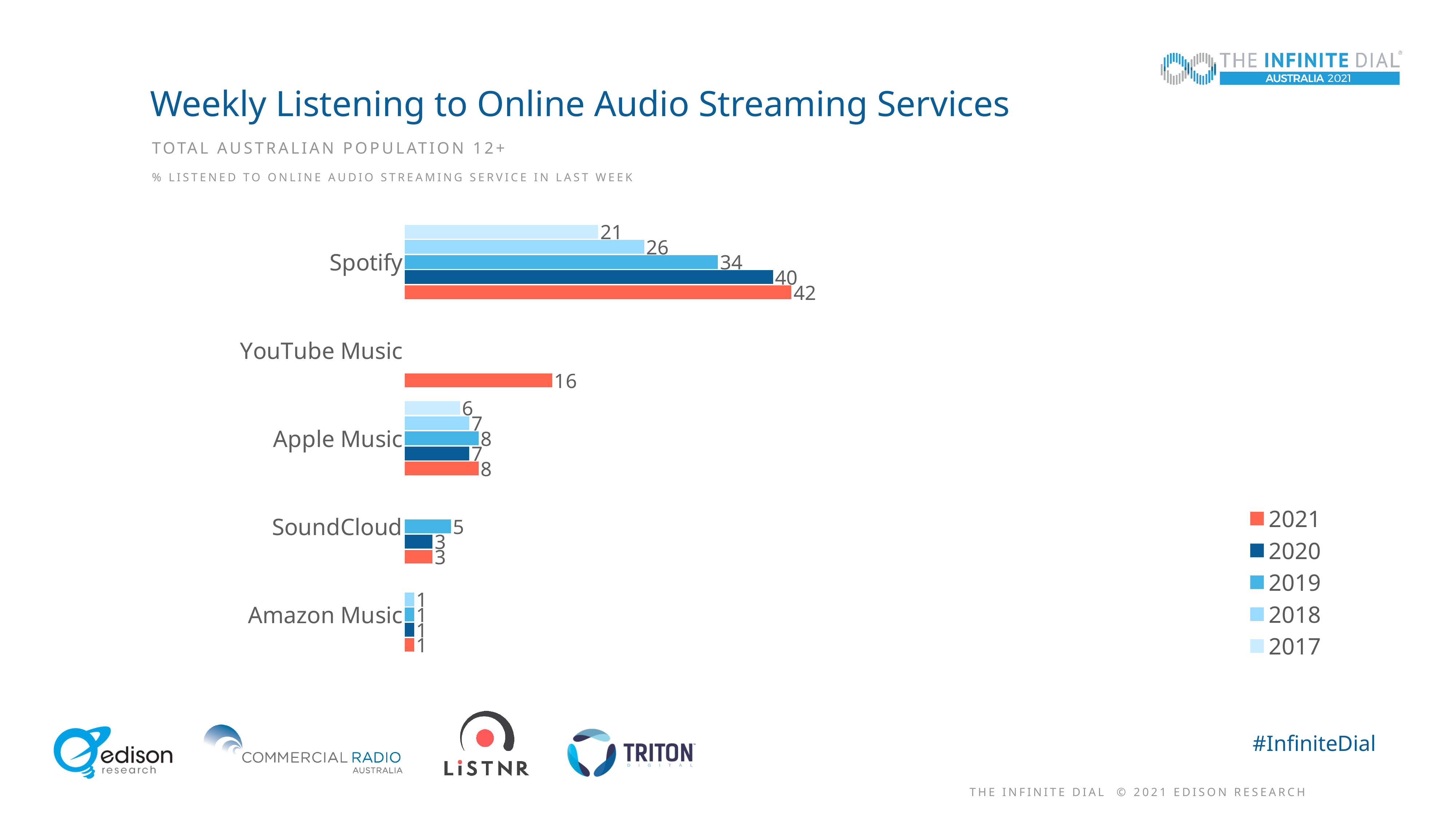
What is the 2021 value for YouTube Music? 16 How many series does the legend list? 5 What kind of chart is shown on the slide? Bar chart Did Spotify's value rise or fall from 2017 to 2021? Rise Which service has the lowest 2021 value? Amazon Music Which service has the highest 2021 value? Spotify What is the 2017 value for Spotify? 21 What is the 2019 value for SoundCloud? 5 What is the difference between Spotify's 2021 value and its 2017 value? 21 What is the 2021 value for Spotify? 42 How many streaming services are listed on the chart? 5 Which is larger, the 2021 value for YouTube Music or the 2021 value for Apple Music? YouTube Music